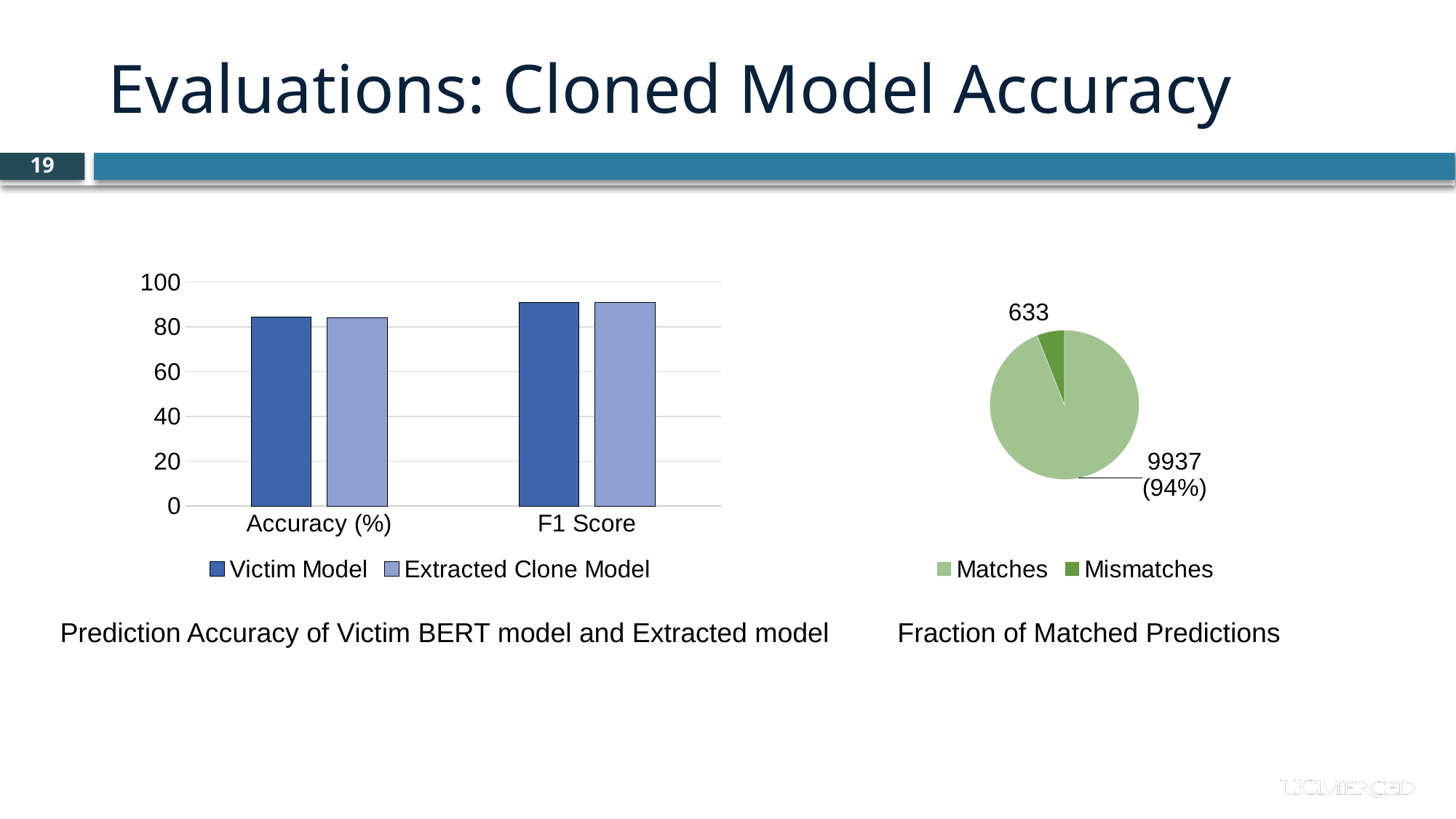
In the right pie chart, what share of the pie do Matches represent? 94% In the left bar chart, which category has the lowest Extracted Clone Model value? Accuracy (%) In the right pie chart, what is the value for Mismatches? 633 In the left bar chart, is the Victim Model value for Accuracy (%) greater or less than 80? greater In the left bar chart, which is larger for the Victim Model: Accuracy (%) or F1 Score? F1 Score In the left bar chart, is the Extracted Clone Model value for F1 Score greater or less than 100? less In the left bar chart, how many series does the legend list? 2 What type of chart is the left chart, captioned 'Prediction Accuracy of Victim BERT model and Extracted model'? bar chart In the right pie chart, what is the value for Matches? 9937 What type of chart is the right chart, captioned 'Fraction of Matched Predictions'? pie chart In the left bar chart, how many categories are shown on the x axis? 2 In the right pie chart, what is the difference between Matches and Mismatches? 9304